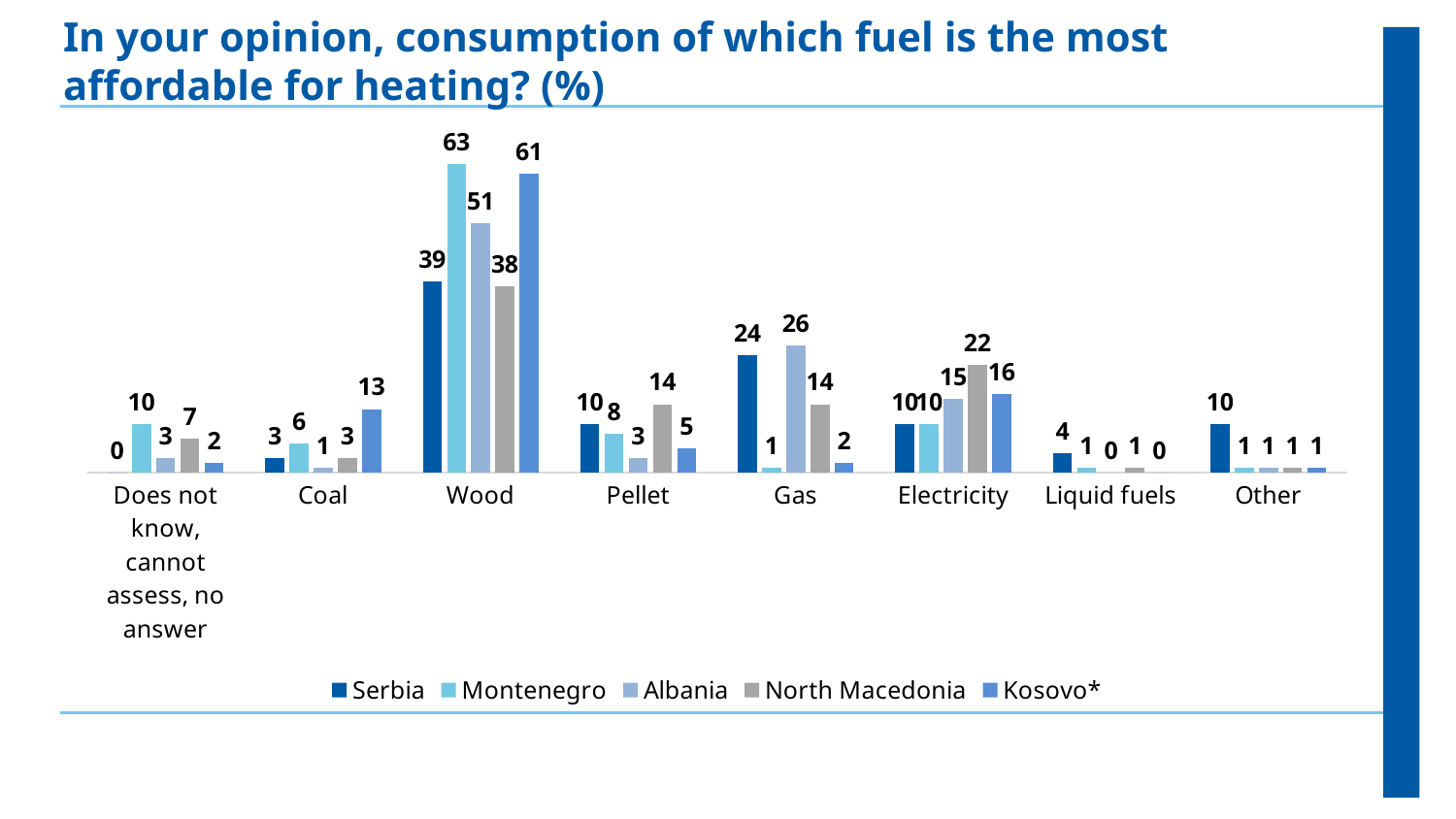
What is the value for North Macedonia in the Electricity category? 22 What is the value for Albania in the Gas category? 26 What kind of chart is shown on the slide? Bar chart What is the value for Kosovo* in the Coal category? 13 What is the value for Montenegro in the Wood category? 63 Which country has the lowest value in the Gas category? Montenegro Which country has the highest value in the Wood category? Montenegro Which category has the highest values across all countries? Wood In the Pellet category, which is larger: the value for Serbia or the value for North Macedonia? North Macedonia How many series does the legend list? 5 What is the difference between the Serbia and Albania values in the Gas category? 2 How many fuel categories are shown on the x axis? 8